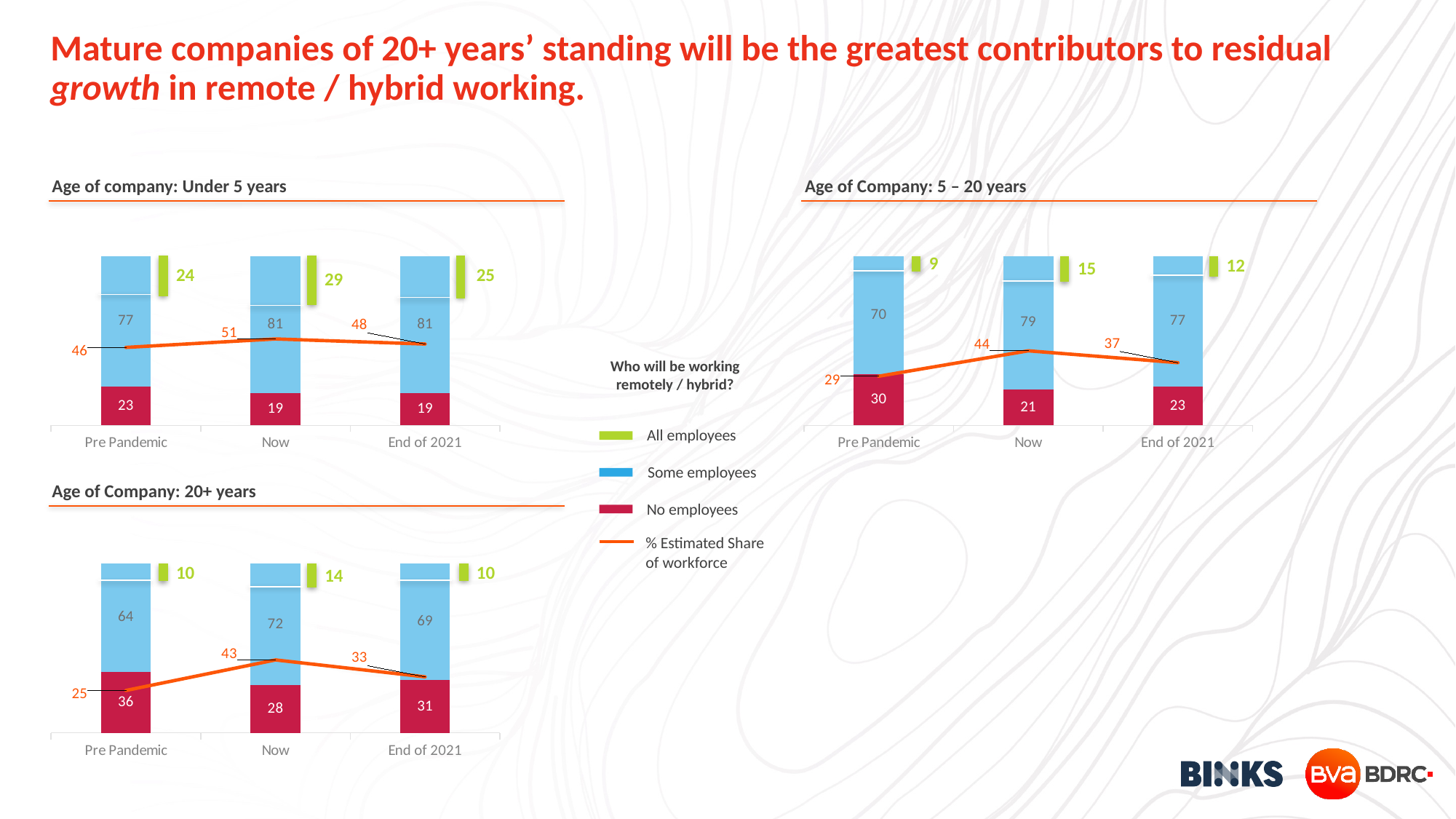
In the 'Age of company: Under 5 years' chart, what is the % Estimated Share of workforce value for Now? 51 How many categories are shown on the x axis of the 'Age of company: Under 5 years' chart? 3 In the 'Age of Company: 5 – 20 years' chart, is the Some employees value larger for Now or for Pre Pandemic? Now In the 'Age of Company: 20+ years' chart, does the % Estimated Share of workforce rise or fall from Now to End of 2021? fall In the 'Age of Company: 20+ years' chart, what is the Some employees value for Now? 72 In the 'Age of Company: 20+ years' chart, what is the All employees value for End of 2021? 10 How many series does the shared legend list? 4 In the 'Age of company: Under 5 years' chart, what is the difference between the All employees values for Now and Pre Pandemic? 5 In the 'Age of Company: 20+ years' chart, which category has the lowest No employees value? Now In the 'Age of Company: 20+ years' chart, what is the difference between the % Estimated Share of workforce for Now and Pre Pandemic? 18 In the 'Age of Company: 5 – 20 years' chart, what is the No employees value for Pre Pandemic? 30 In the 'Age of Company: 5 – 20 years' chart, which category has the highest % Estimated Share of workforce? Now